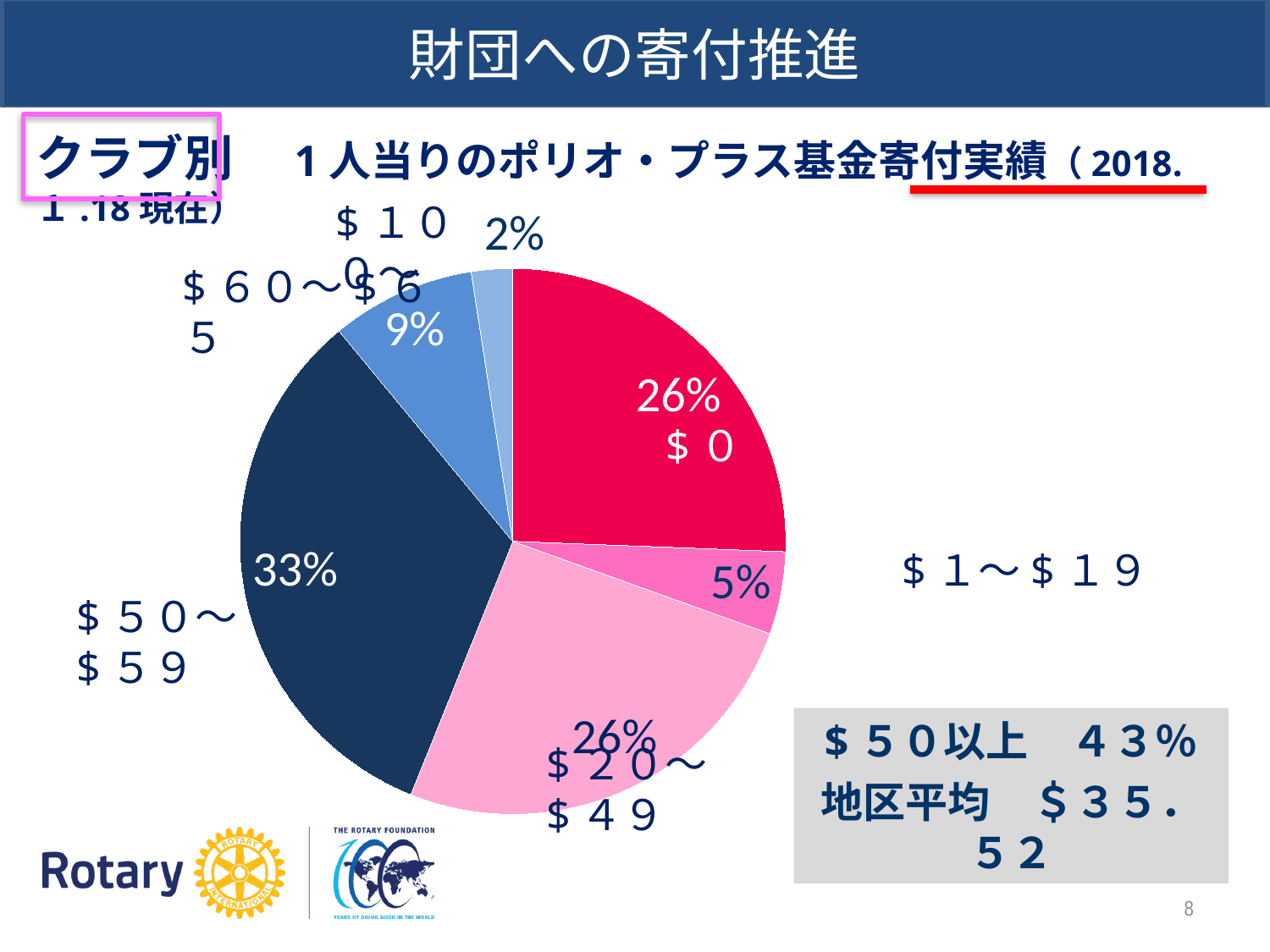
What percentage of the pie is the $50～$59 slice? 33% What percentage of the pie is the $1～$19 slice? 5% Which category has the largest share of the pie? $50～$59 What is the combined share of the $0 and $1～$19 slices? 31% What is the smallest percentage shown on the pie chart? 2% What percentage of the pie is the $0 slice? 26% What kind of chart is shown on the slide? pie chart By how many percentage points does the $50～$59 slice exceed the $20～$49 slice? 7 percentage points What colour is the $50～$59 slice of the pie? dark navy blue How many slices does the pie chart have? 6 What percentage of the pie is the $20～$49 slice? 26% Which slice is larger, $1～$19 or $50～$59? $50～$59